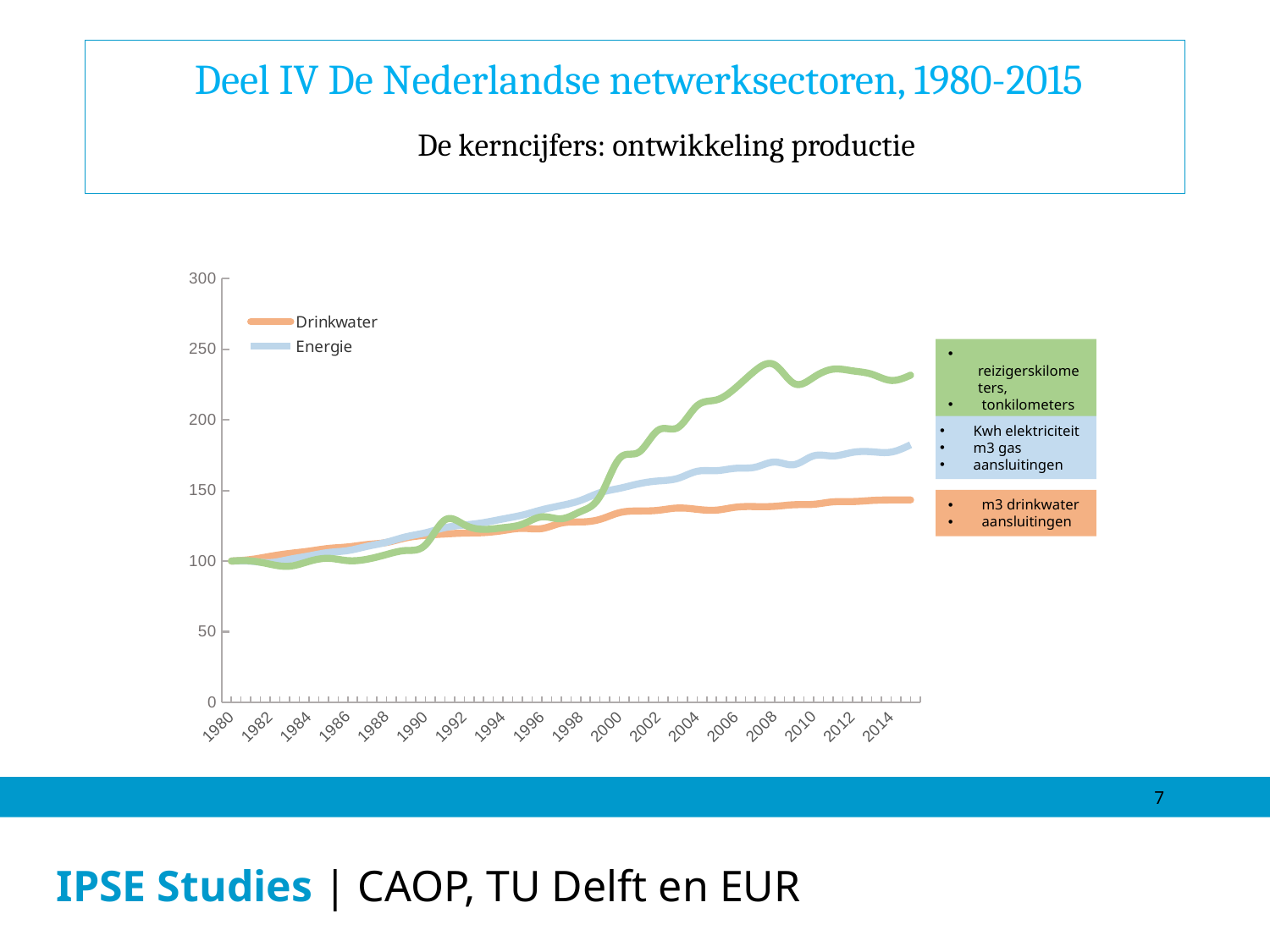
Is the value of the Drinkwater line in 2014 greater or less than 150? less Is the value of the green line in 2008 greater or less than 200? greater In 2014, which line has the higher value, Energie or Drinkwater? Energie Does the Drinkwater line generally rise or fall from 1980 to 2014? rise In 2010, which line has the higher value, the green line or the Energie line? the green line Is the value of the Energie line in 2014 greater or less than 200? less What colour is the Drinkwater line in the chart? orange How many series does the chart's legend list? 2 What kind of chart is shown on the slide? line chart Which two series are named in the chart's legend? Drinkwater and Energie